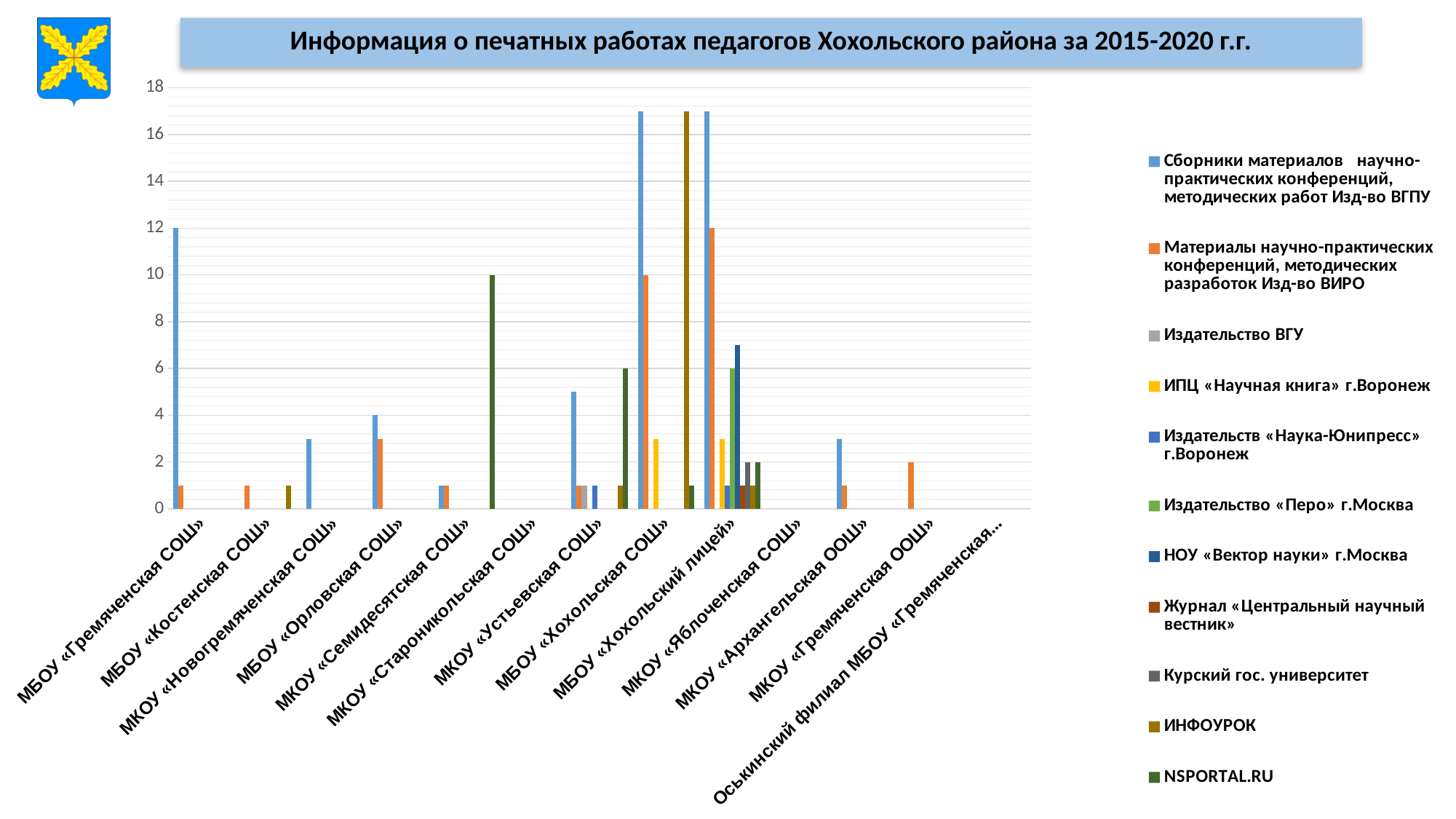
What is the value of the «Материалы научно-практических конференций, методических разработок Изд-во ВИРО» series for МКОУ «Гремяченская ООШ»? 2 How many school categories are shown along the x axis? 13 Which has the larger Изд-во ВГПУ value: МБОУ «Гремяченская СОШ» or МБОУ «Орловская СОШ»? МБОУ «Гремяченская СОШ» Which school has bars for the largest number of different publishers? МБОУ «Хохольский лицей» How many series does the legend list? 11 What is the value of the «Сборники материалов научно-практических конференций, методических работ Изд-во ВГПУ» series for МБОУ «Орловская СОШ»? 4 Is the value of the Изд-во ВГПУ series for МКОУ «Новогремяченская СОШ» greater or less than 4? less What kind of chart is shown on the slide? bar chart Which series is shown in the last legend entry? NSPORTAL.RU Is the value of the Изд-во ВГПУ series for МКОУ «Архангельская ООШ» greater or less than 4? less What is the value of the «Сборники материалов научно-практических конференций, методических работ Изд-во ВГПУ» series for МБОУ «Гремяченская СОШ»? 12 What is the title of the chart? Информация о печатных работах педагогов Хохольского района за 2015-2020 г.г.